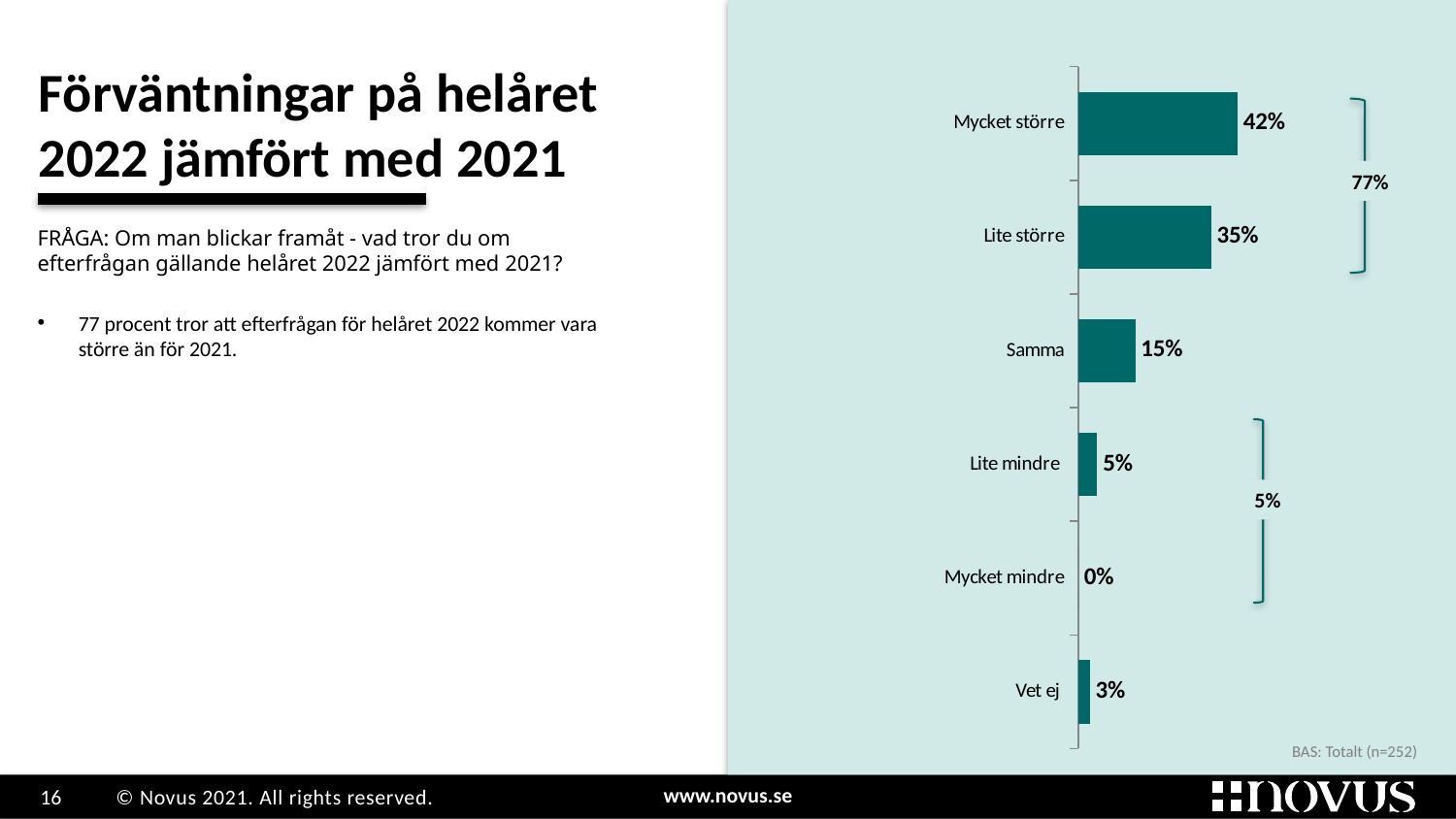
What is the sample size (n) given in the base note of the chart? 252 Which is larger, the value for "Samma" or the value for "Lite mindre"? Samma What kind of chart is shown on the slide? Bar chart What is the difference between the values for "Mycket större" and "Lite större"? 7% Which category has the highest value? Mycket större What combined percentage is shown by the bracket grouping "Mycket större" and "Lite större"? 77% Which category has the lowest value? Mycket mindre How many categories are shown in the chart? 6 What is the value for "Vet ej"? 3% What is the value for "Lite större"? 35% What is the value for "Mycket större"? 42% What is the value for "Samma"? 15%